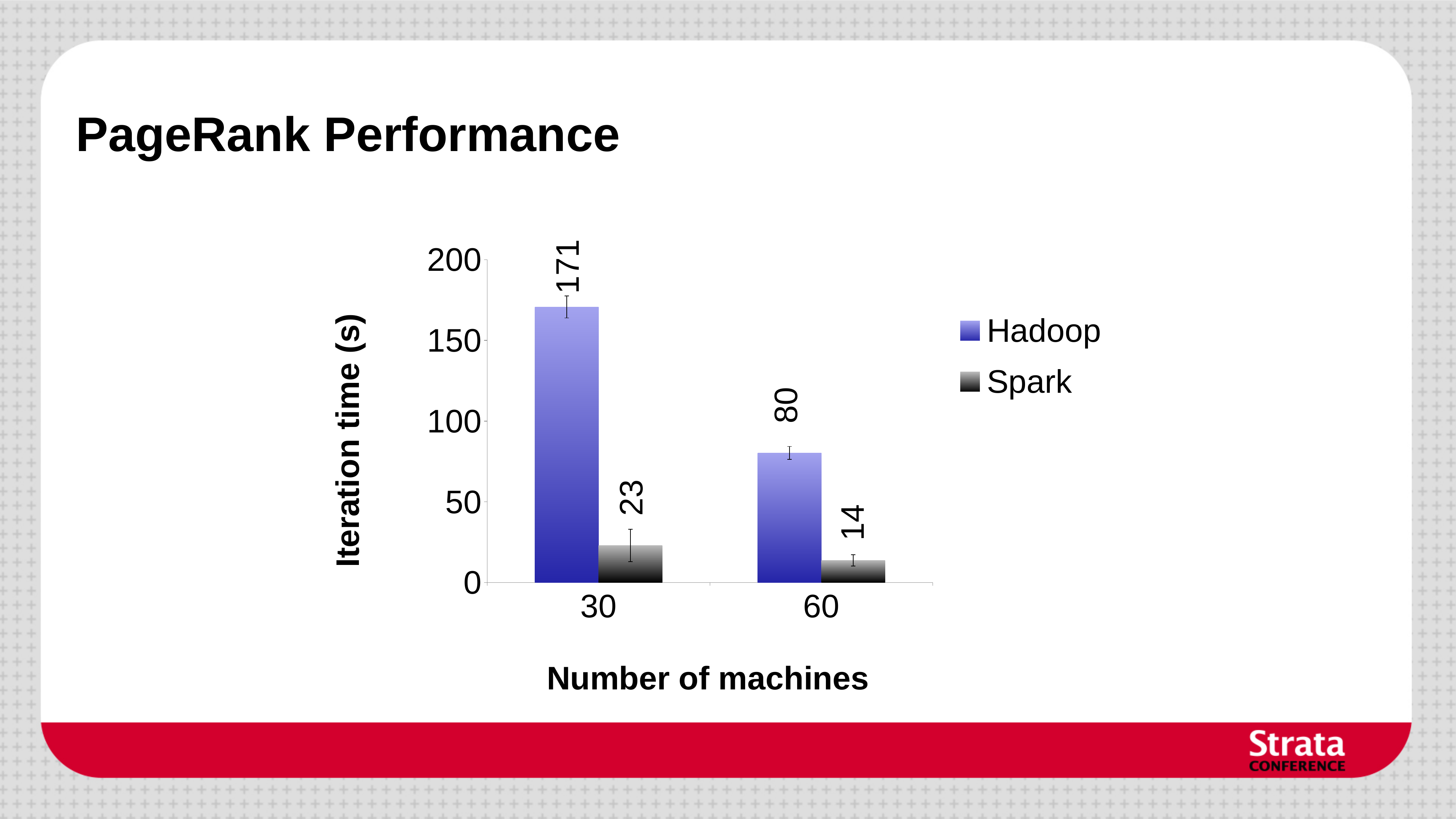
Which is larger: the Hadoop iteration time at 60 machines or the Spark iteration time at 30 machines? Hadoop at 60 machines Is the Hadoop iteration time at 30 machines greater or less than 150? greater How many series does the legend list? 2 What is the iteration time for Hadoop with 60 machines? 80 What is the label of the y axis? Iteration time (s) What is the iteration time for Spark with 30 machines? 23 Which bar has the lowest iteration time on the chart? Spark at 60 machines What is the iteration time for Hadoop with 30 machines? 171 What is the iteration time for Spark with 60 machines? 14 What is the difference between the Hadoop iteration times at 30 and 60 machines? 91 Which series has the highest iteration time at 30 machines? Hadoop What kind of chart is shown on the slide? Bar chart